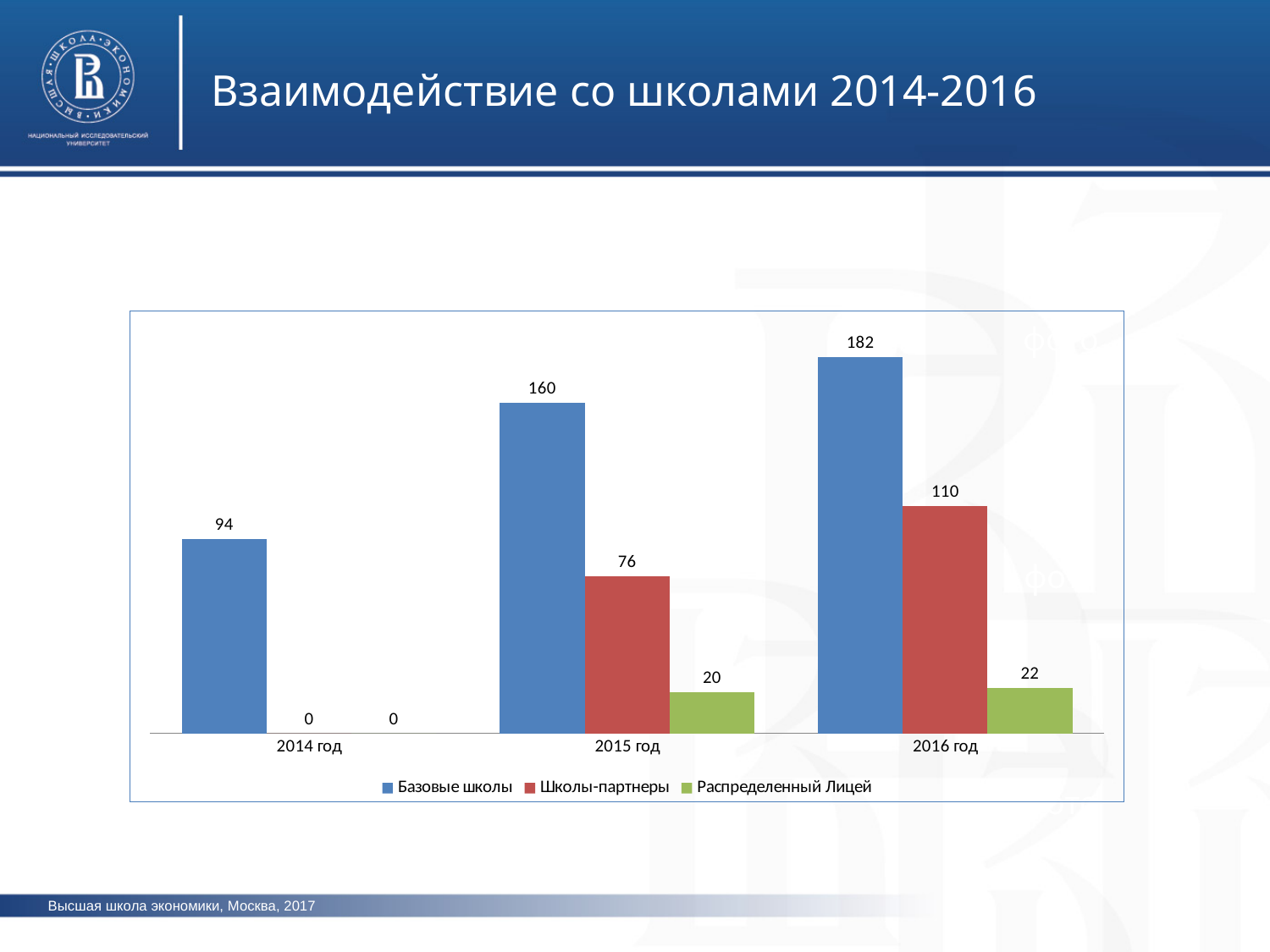
What is the difference between Базовые школы in 2016 год and 2015 год? 22 What is the value for Базовые школы in 2016 год? 182 What kind of chart is shown on the slide? Bar chart What is the value for Школы-партнеры in 2015 год? 76 In which year is the value for Базовые школы highest? 2016 год What is the value for Школы-партнеры in 2014 год? 0 What is the difference between Школы-партнеры in 2016 год and 2015 год? 34 Which is larger in 2015 год: Базовые школы or Школы-партнеры? Базовые школы How many series does the legend list? 3 In which year is the value for Базовые школы lowest? 2014 год What is the value for Распределенный Лицей in 2016 год? 22 How many years are shown on the x axis? 3